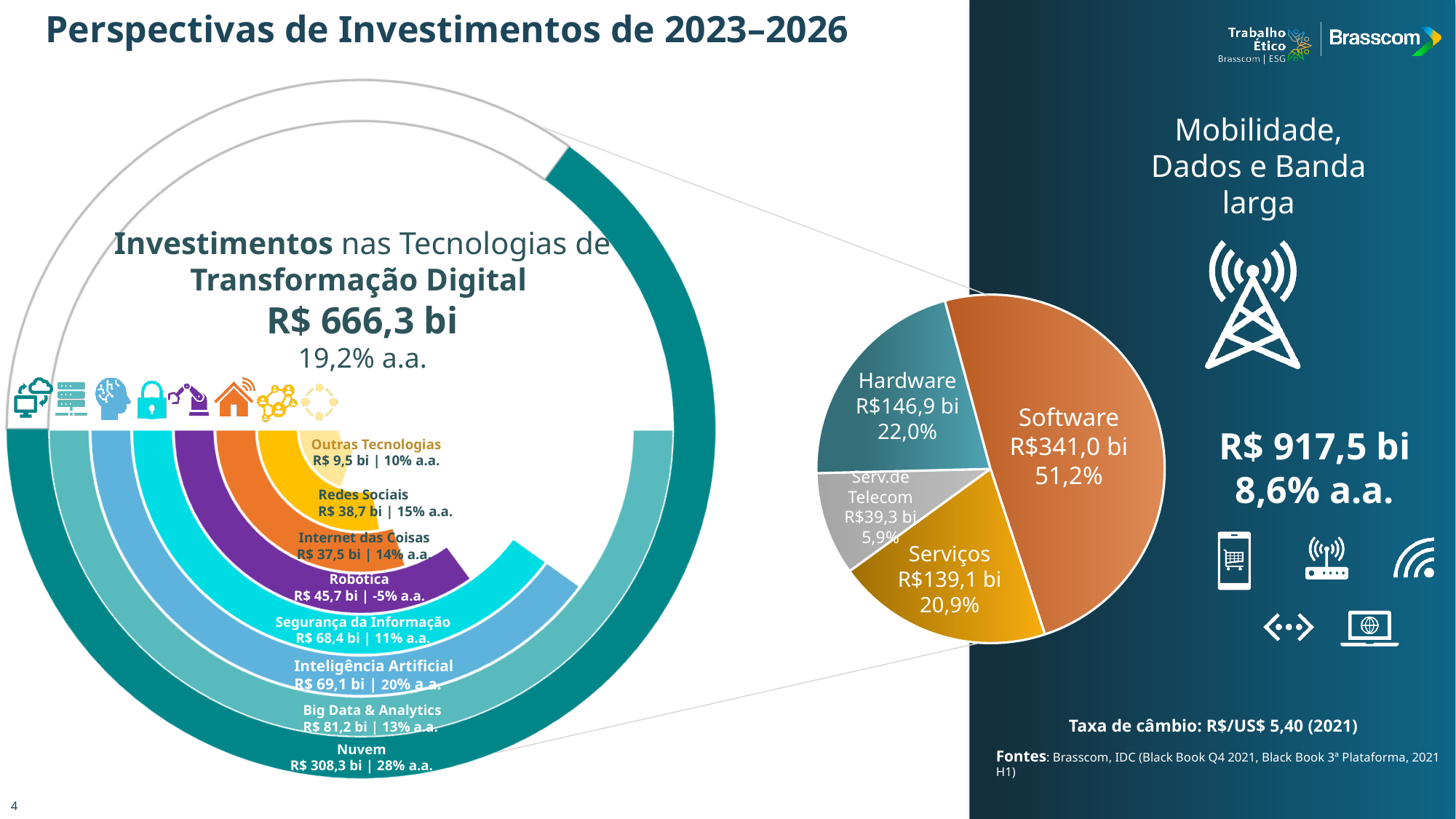
In the pie chart, what share does Hardware represent? 22,0% In the 'Investimentos nas Tecnologias de Transformação Digital' chart, what is the investment value for Nuvem? R$ 308,3 bi How many slices does the pie chart have? 4 In the pie chart, which segment is the largest? Software In the pie chart, which segment is the smallest? Serv. de Telecom In the pie chart, what is the investment value shown for Software? R$341,0 bi In the pie chart, what is the difference between the Hardware and Serviços values? R$7,8 bi In the 'Investimentos nas Tecnologias de Transformação Digital' chart, which has the larger investment value, Redes Sociais or Internet das Coisas? Redes Sociais In the 'Investimentos nas Tecnologias de Transformação Digital' chart, what is the difference between the Big Data & Analytics and Inteligência Artificial values? R$ 12,1 bi In the 'Investimentos nas Tecnologias de Transformação Digital' chart, what annual growth rate is shown for Robótica? -5% a.a. What kind of chart is the chart on the right showing Software, Hardware, Serviços and Serv. de Telecom? Pie chart How many technology categories are shown in the 'Investimentos nas Tecnologias de Transformação Digital' chart? 8